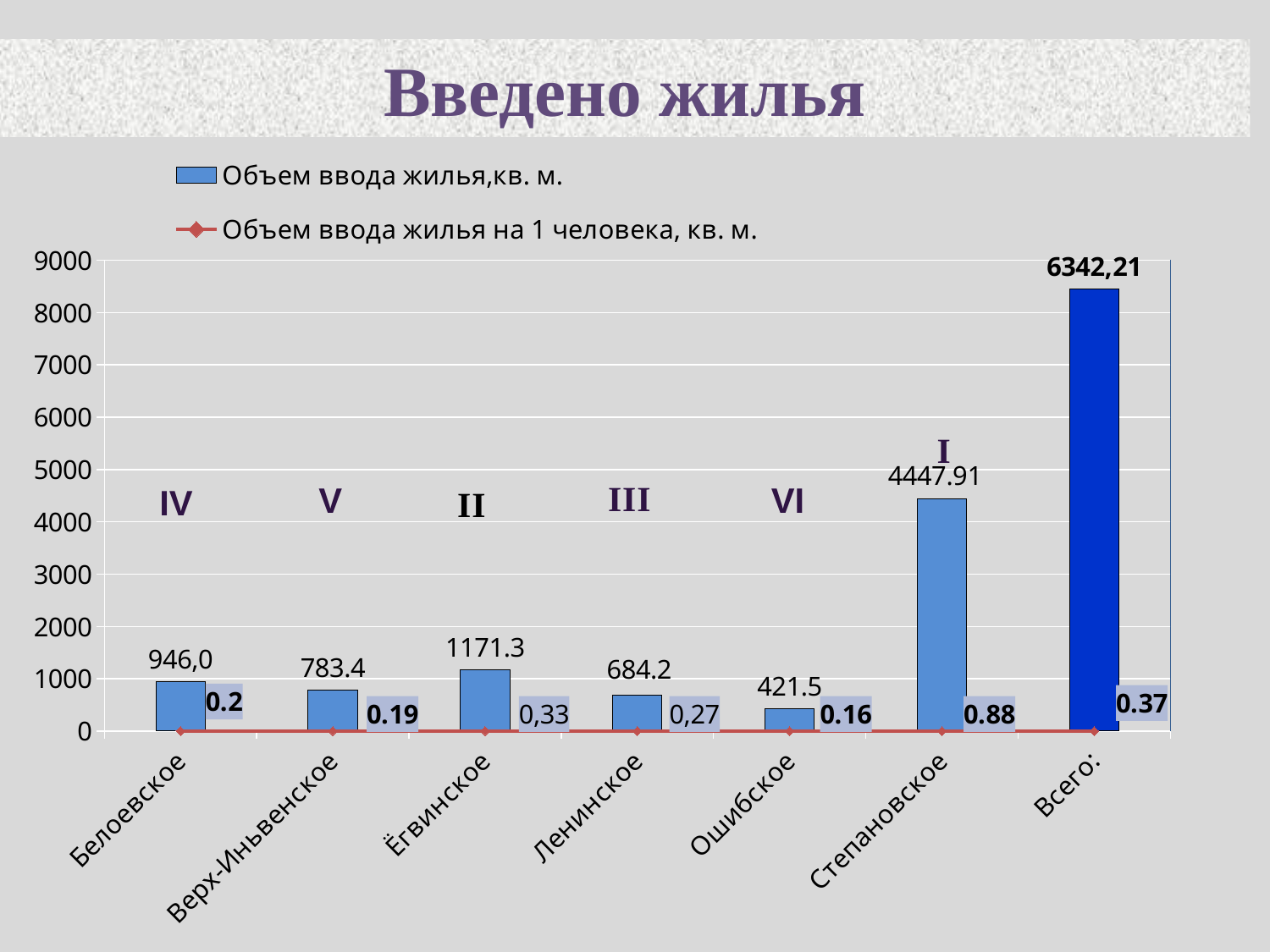
How many categories are shown on the x axis? 7 What is the value of Объем ввода жилья на 1 человека, кв. м. for Степановское? 0.88 What is the difference in Объем ввода жилья, кв. м. between Ёгвинское and Ленинское? 487.1 What is the value of Объем ввода жилья, кв. м. for Степановское? 4447.91 Which has a larger value of Объем ввода жилья, кв. м.: Белоевское or Верх-Иньвенское? Белоевское Is the bar value for Степановское greater or less than 4000? greater Which category has the highest value of Объем ввода жилья на 1 человека, кв. м.? Степановское What is the value of Объем ввода жилья, кв. м. for Всего:? 6342,21 What is the value of Объем ввода жилья, кв. м. for Ёгвинское? 1171.3 Among the individual settlements (excluding Всего:), which category has the lowest value of Объем ввода жилья, кв. м.? Ошибское How many series does the legend list? 2 What is the value of Объем ввода жилья на 1 человека, кв. м. for Ленинское? 0,27